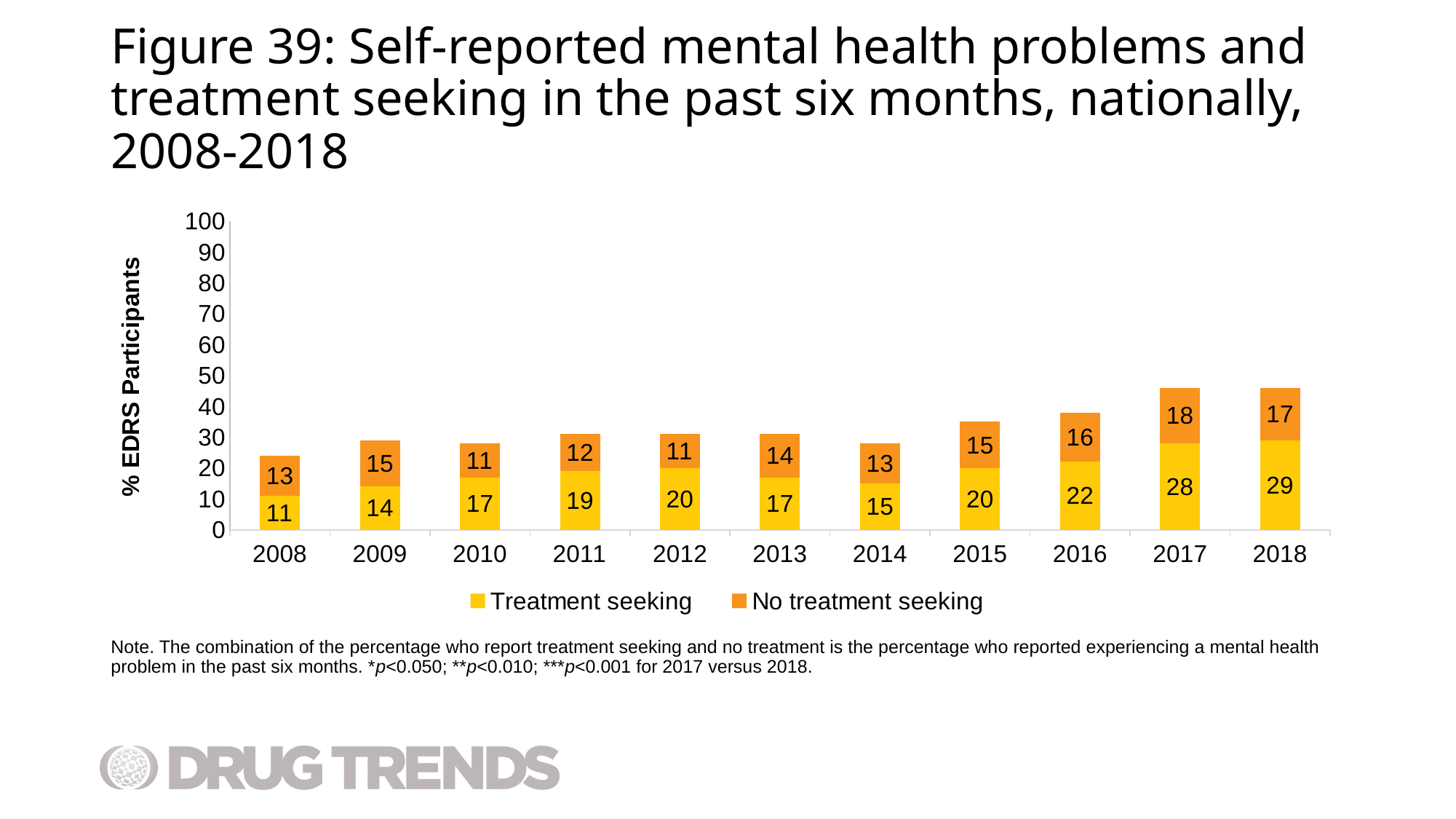
What is the label of the y axis? % EDRS Participants Which is larger, the No treatment seeking value for 2017 or for 2010? 2017 Which year has the lowest Treatment seeking value? 2008 What is the total of the stacked bar for 2017? 46 What is the difference between the Treatment seeking values for 2018 and 2008? 18 What is the No treatment seeking value for 2009? 15 What is the Treatment seeking value for 2012? 20 What is the total of the stacked bar for 2008? 24 How many series does the legend list? 2 How many years are shown on the x axis? 11 What kind of chart is shown? Stacked bar chart Which year has the highest Treatment seeking value? 2018